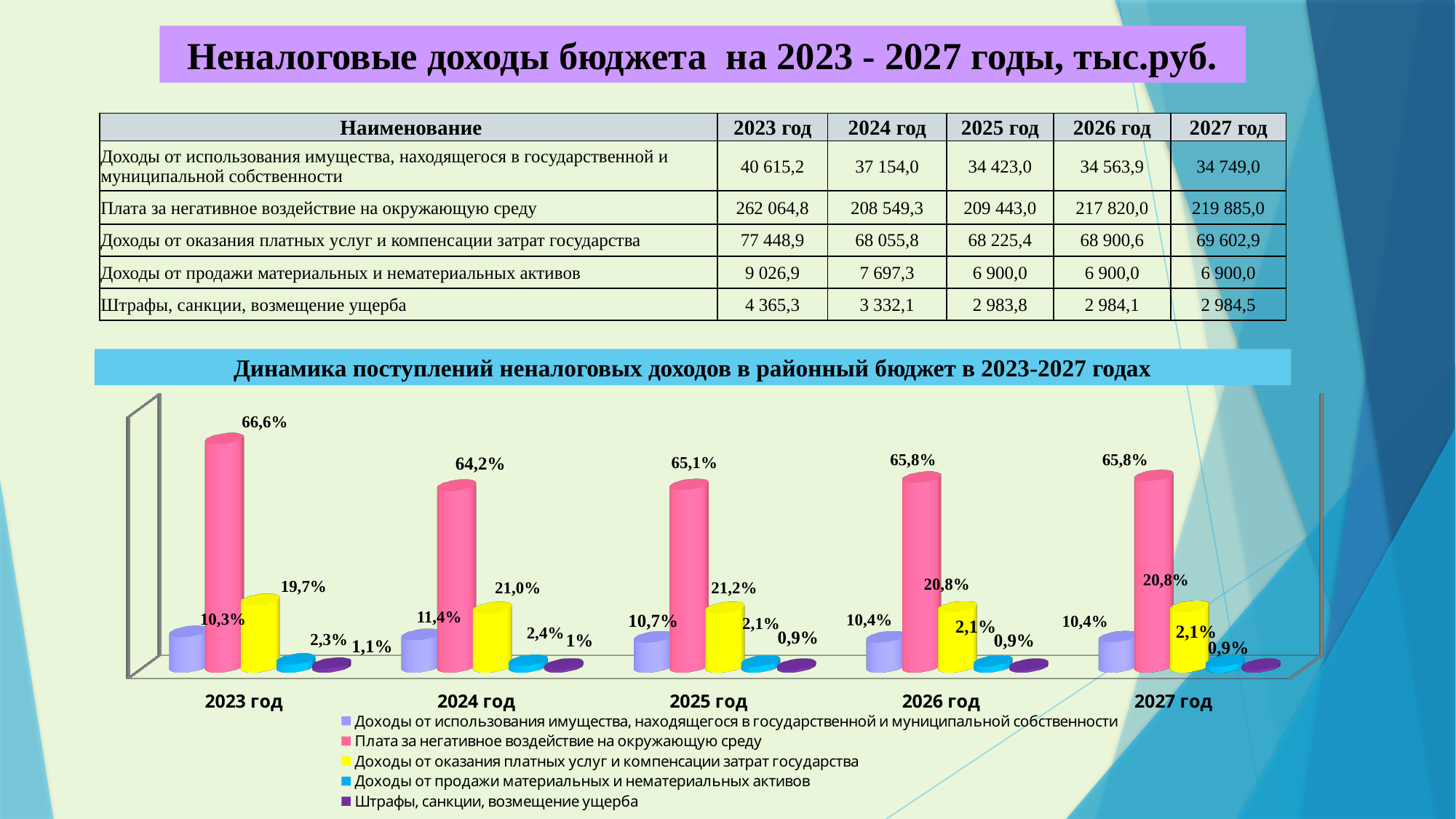
In which year is the value for 'Плата за негативное воздействие на окружающую среду' the highest? 2023 год What type of chart is shown on the slide? bar chart How many year categories are shown on the x axis of the chart? 5 What is the value for 'Доходы от использования имущества, находящегося в государственной и муниципальной собственности' in 2024 год? 11,4% What is the value for 'Плата за негативное воздействие на окружающую среду' in 2023 год? 66,6% What is the value for 'Штрафы, санкции, возмещение ущерба' in 2023 год? 1,1% In which year is the value for 'Плата за негативное воздействие на окружающую среду' the lowest? 2024 год What is the title of the chart? Динамика поступлений неналоговых доходов в районный бюджет в 2023-2027 годах What is the difference between the 2023 год and 2024 год values for 'Плата за негативное воздействие на окружающую среду'? 2,4% How many series does the chart legend list? 5 What is the value for 'Доходы от оказания платных услуг и компенсации затрат государства' in 2025 год? 21,2% Which is larger in 2023 год: 'Доходы от использования имущества, находящегося в государственной и муниципальной собственности' or 'Доходы от оказания платных услуг и компенсации затрат государства'? Доходы от оказания платных услуг и компенсации затрат государства